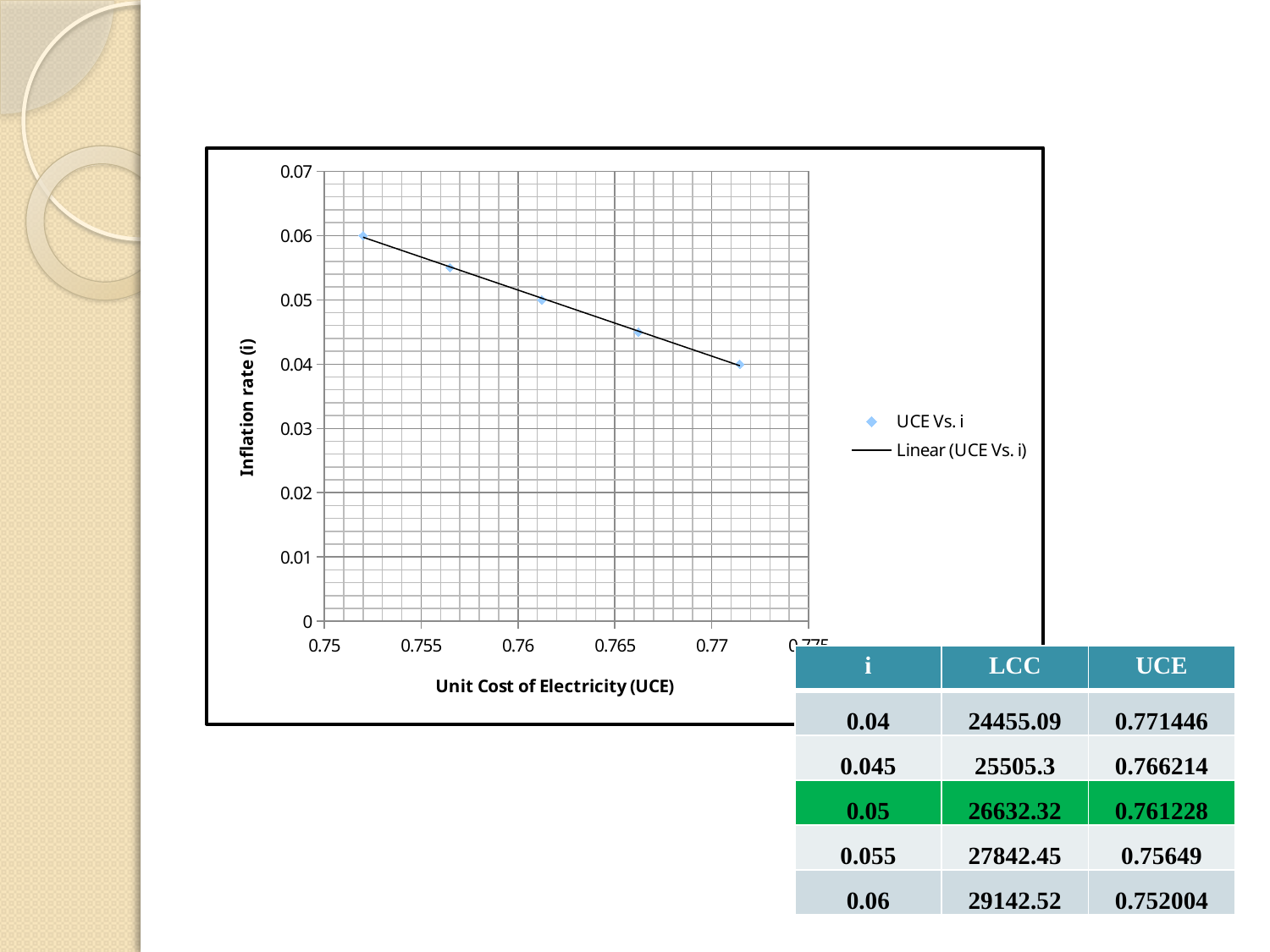
How many entries does the chart legend list? 2 What is the inflation rate of the middle (third from left) data point? 0.05 Which point has the higher inflation rate, the leftmost point or the rightmost point? the leftmost point What is the lowest inflation rate value plotted on the chart? 0.04 Is the unit cost of electricity for the rightmost point greater or less than 0.77? greater Is the inflation rate of the second point from the left greater or less than 0.05? greater What kind of chart is shown on the slide? scatter chart What is the title of the x axis of the chart? Unit Cost of Electricity (UCE) Is the unit cost of electricity for the leftmost point greater or less than 0.755? less Does the inflation rate rise or fall as the unit cost of electricity increases along the x axis? fall What is the highest inflation rate value plotted on the chart? 0.06 How many data points are plotted in the UCE Vs. i series? 5